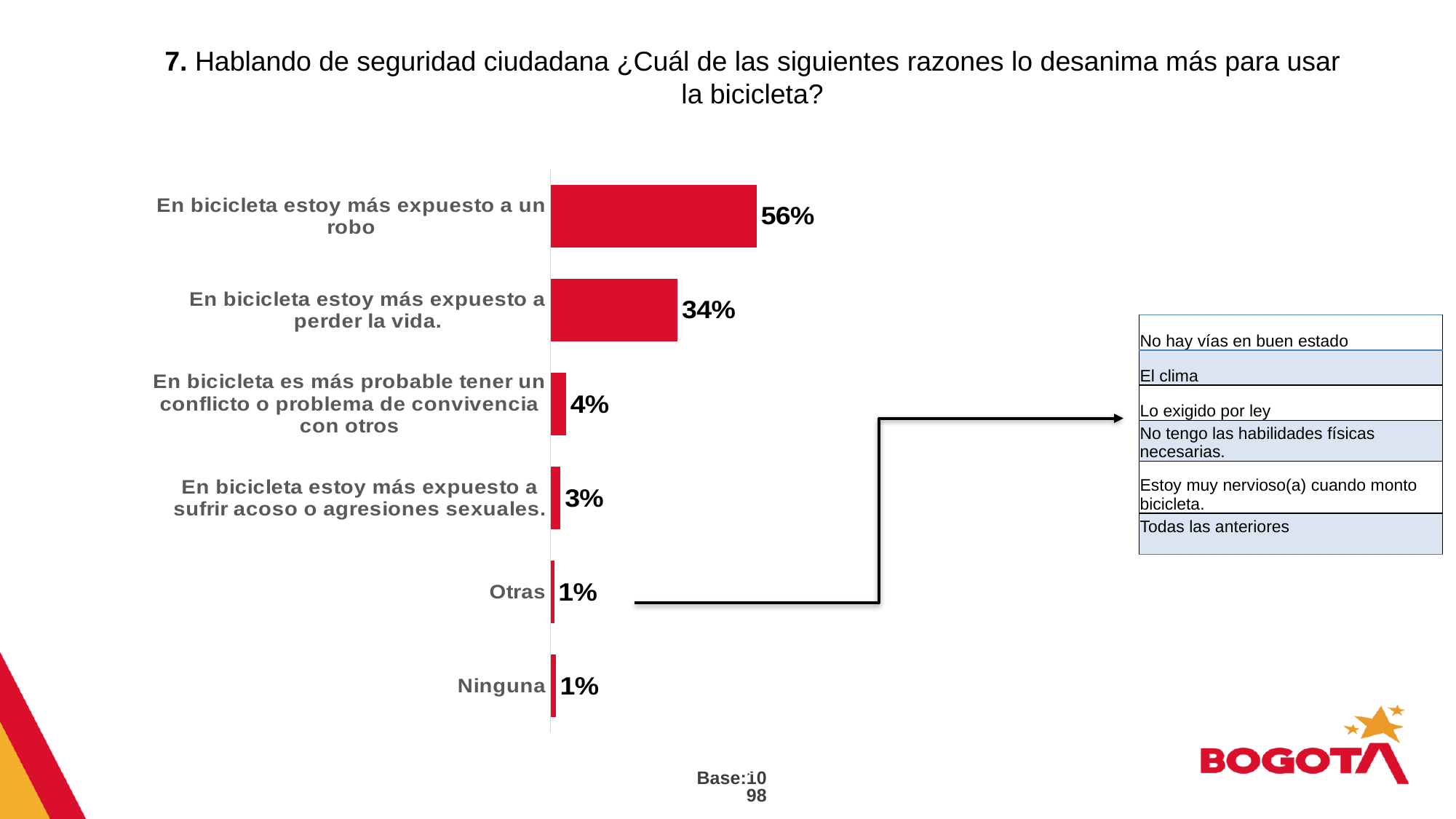
What percentage is shown for "En bicicleta estoy más expuesto a un robo"? 56% What colour are the bars in the chart? Red What percentage is shown for "Otras"? 1% What kind of chart is shown on the slide? Bar chart Which is larger: the value for "En bicicleta es más probable tener un conflicto o problema de convivencia con otros" or the value for "En bicicleta estoy más expuesto a sufrir acoso o agresiones sexuales."? En bicicleta es más probable tener un conflicto o problema de convivencia con otros How many categories are plotted in the chart? 6 Which category has the highest percentage? En bicicleta estoy más expuesto a un robo What is the combined percentage of "Otras" and "Ninguna"? 2% What percentage is shown for "En bicicleta es más probable tener un conflicto o problema de convivencia con otros"? 4% What percentage is shown for "En bicicleta estoy más expuesto a perder la vida."? 34% What is the difference in percentage points between "En bicicleta estoy más expuesto a un robo" and "En bicicleta estoy más expuesto a perder la vida."? 22 percentage points What percentage is shown for "En bicicleta estoy más expuesto a sufrir acoso o agresiones sexuales."? 3%